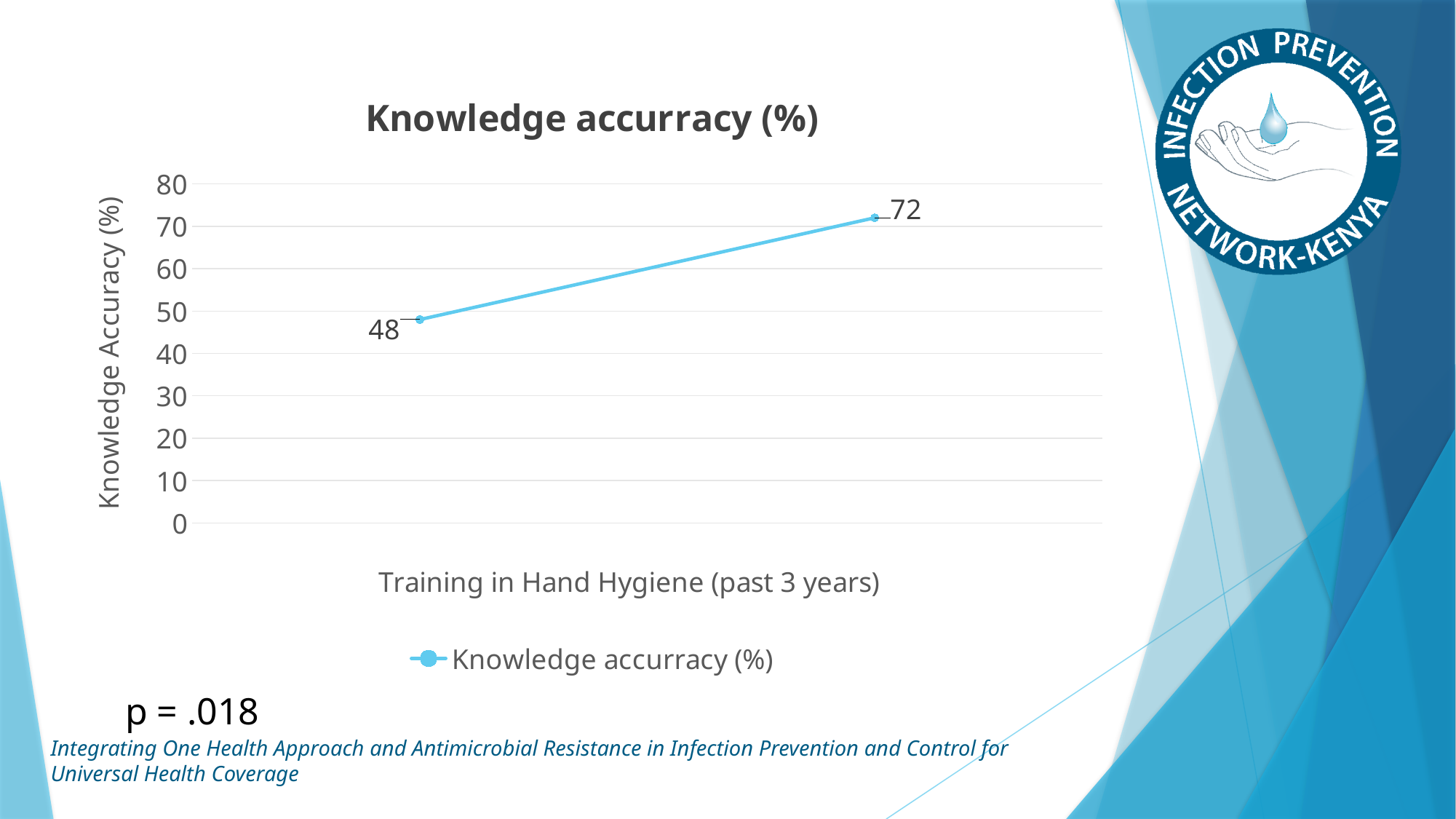
Does the line rise or fall from left to right? rise What is the difference between the two plotted values, 72 and 48? 24 What is the lowest value plotted on the chart? 48 What is the label of the x axis? Training in Hand Hygiene (past 3 years) Which data point is larger, the left one or the right one? the right one How many data points are plotted on the line? 2 What is the title of the chart? Knowledge accurracy (%) What is the value of the left (first) data point on the line? 48 What kind of chart is shown on the slide? line chart What is the value of the right (second) data point on the line? 72 What is the highest value plotted on the chart? 72 How many series does the legend list? 1